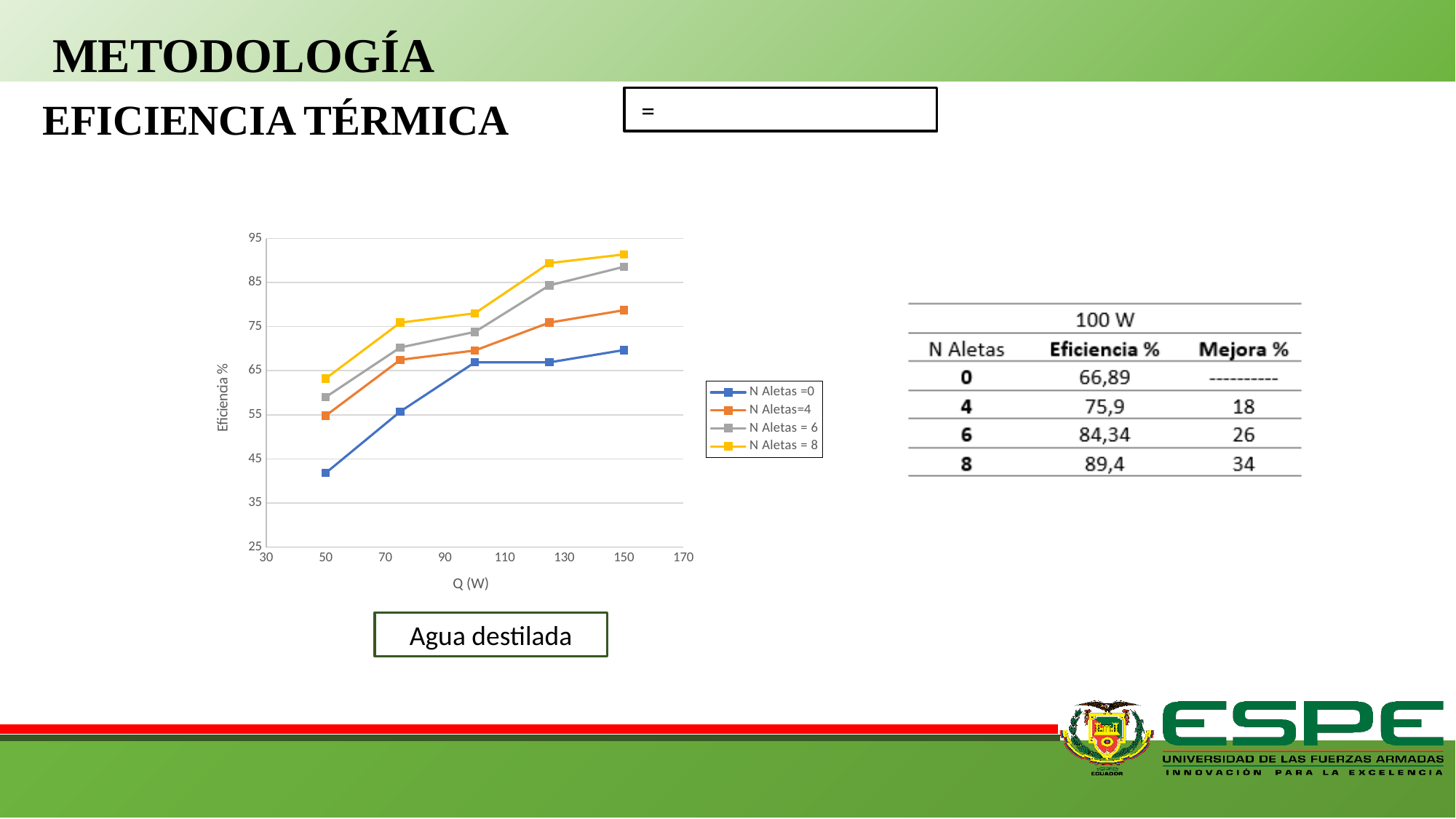
Which series has the highest efficiency at 150 W? N Aletas = 8 Is the value for N Aletas = 8 at 50 W greater or less than 65? less Which series has the lowest efficiency at 50 W? N Aletas =0 Do the efficiency values for N Aletas = 8 rise or fall as Q (W) increases? rise Is the value for N Aletas =0 at 50 W greater or less than 45? less At 100 W, which is larger: the value for N Aletas = 6 or N Aletas=4? N Aletas = 6 Is the value for N Aletas =0 at 150 W greater or less than 65? greater How many series does the chart's legend list? 4 What kind of chart is shown on the slide? line chart What is the label of the chart's x axis? Q (W) How many data points does the N Aletas =0 series have? 5